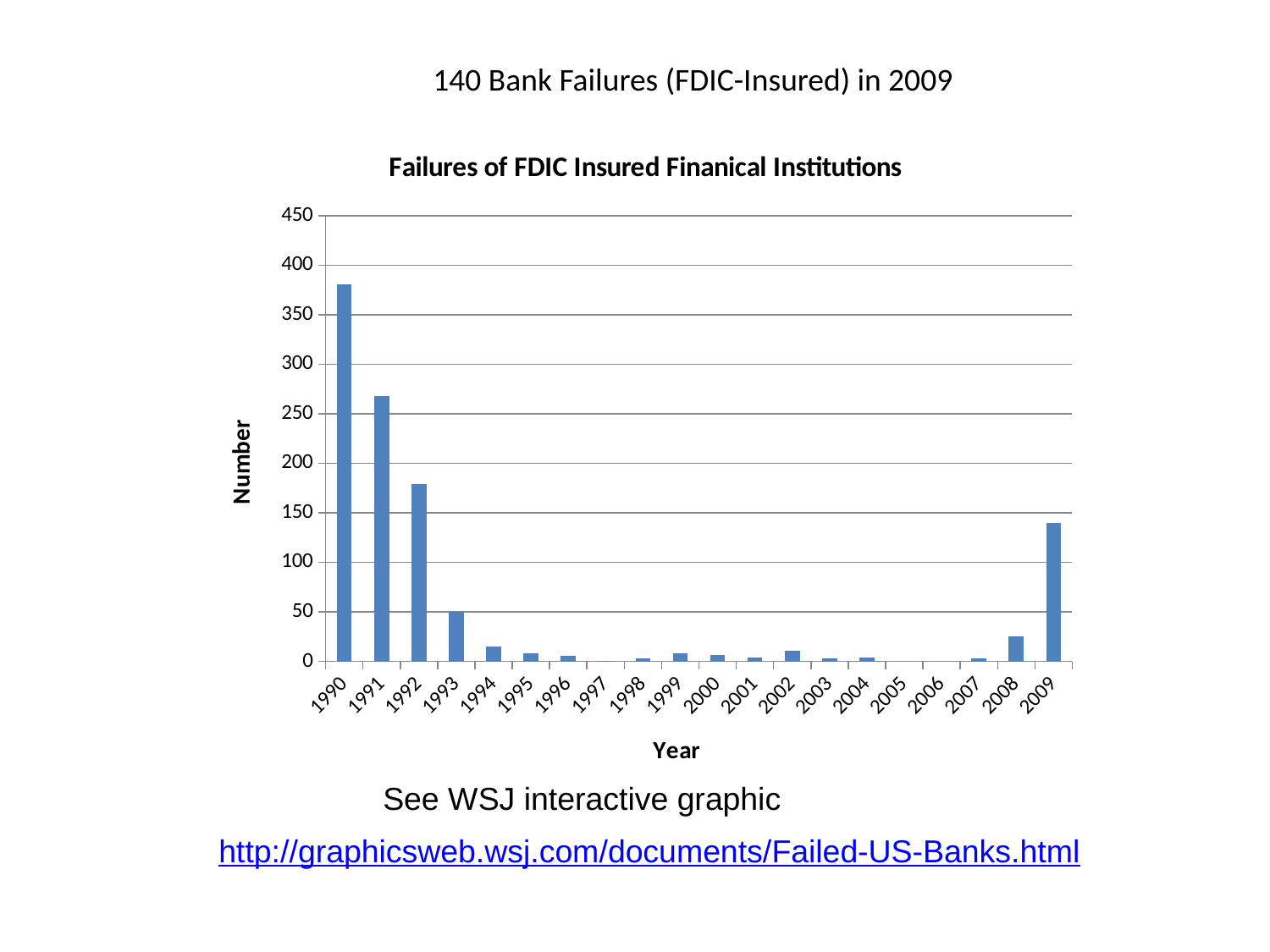
What type of chart is shown on the slide? Bar chart Which year has the highest number of failures in the chart? 1990 How many years are shown on the x axis of the chart? 20 Is the value for 1990 greater or less than 350? greater Is the value for 1992 greater or less than 150? greater Which year has the larger value, 1991 or 1992? 1991 Is the value for 2008 greater or less than 50? less How many bank failures does the slide report for 2009? 140 What is the title of the chart? Failures of FDIC Insured Finanical Institutions What is the label on the vertical axis of the chart? Number Do the values rise or fall from 1990 to 1993? fall